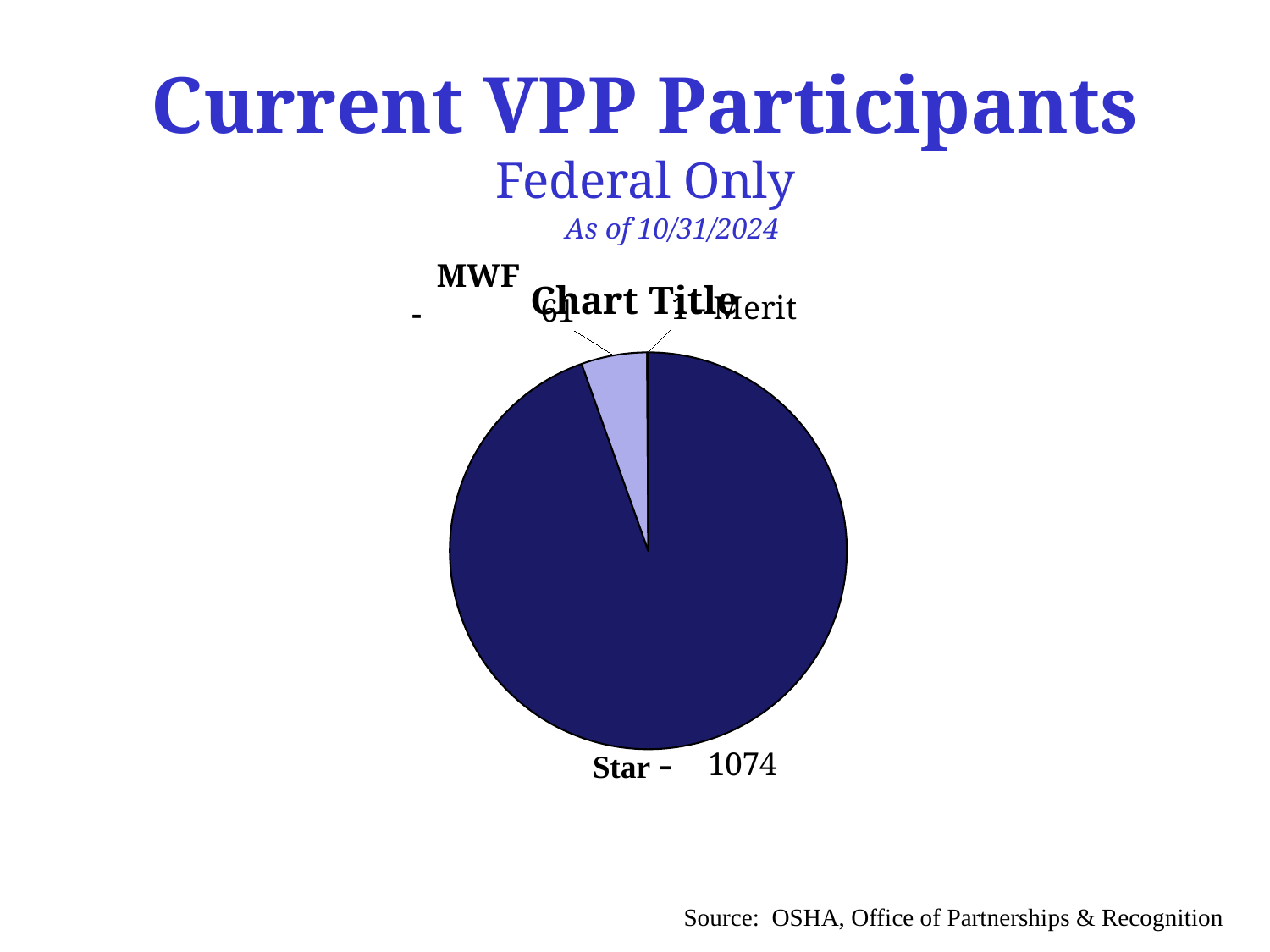
Which is larger, the value for Star or the value for MWF? Star Which category has the smallest slice of the pie? Merit Which category has the largest slice of the pie? Star Is the value for MWF greater or less than 100? less What is the main title of the slide? Current VPP Participants What is the difference between the Star value and the MWF value? 1013 How many slices does the pie chart have? 3 What is the value for the MWF slice? 61 What date is the data on the slide reported as of? 10/31/2024 What kind of chart is shown on the slide? pie chart What is the value for the Star slice? 1074